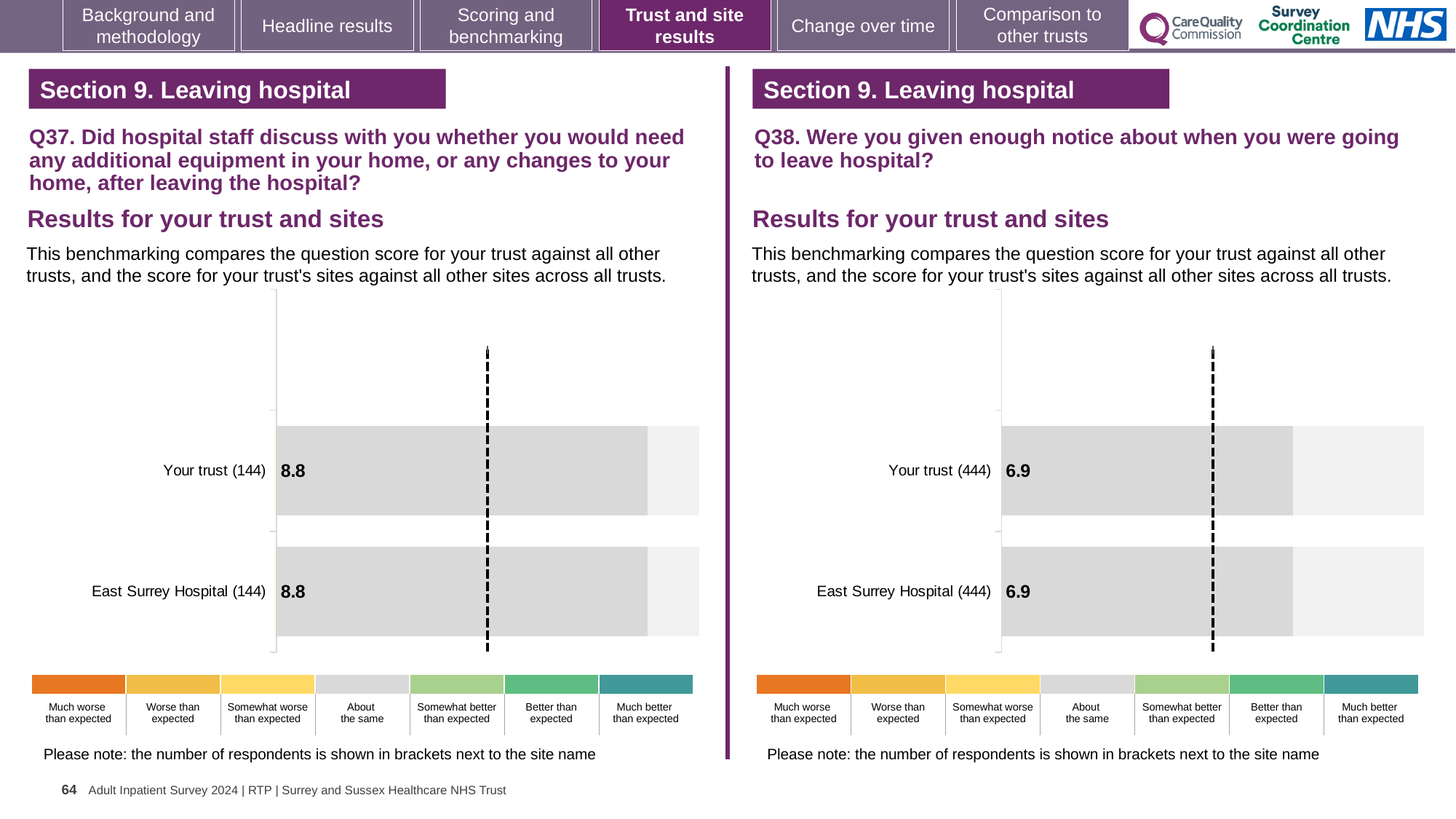
In the Q38 chart on the right, what is the difference between the Your trust score and the East Surrey Hospital score? 0 In the Q37 chart on the left, how many respondents are shown in brackets next to Your trust? 144 In the Q37 chart on the left, what is the score for East Surrey Hospital? 8.8 What kind of chart is used for the Q38 results on the right? Bar chart In the Q37 chart on the left, what is the difference between the Your trust score and the East Surrey Hospital score? 0 In the Q37 chart on the left, what is the score for Your trust? 8.8 In the Q38 chart on the right, what is the score for East Surrey Hospital? 6.9 How many bars are plotted in the Q38 chart on the right? 2 In the Q38 chart on the right, how many respondents are shown in brackets next to East Surrey Hospital? 444 In the Q38 chart on the right, what is the score for Your trust? 6.9 How many bars are plotted in the Q37 chart on the left? 2 Is the Your trust score in the Q37 chart on the left larger or smaller than the Your trust score in the Q38 chart on the right? Larger